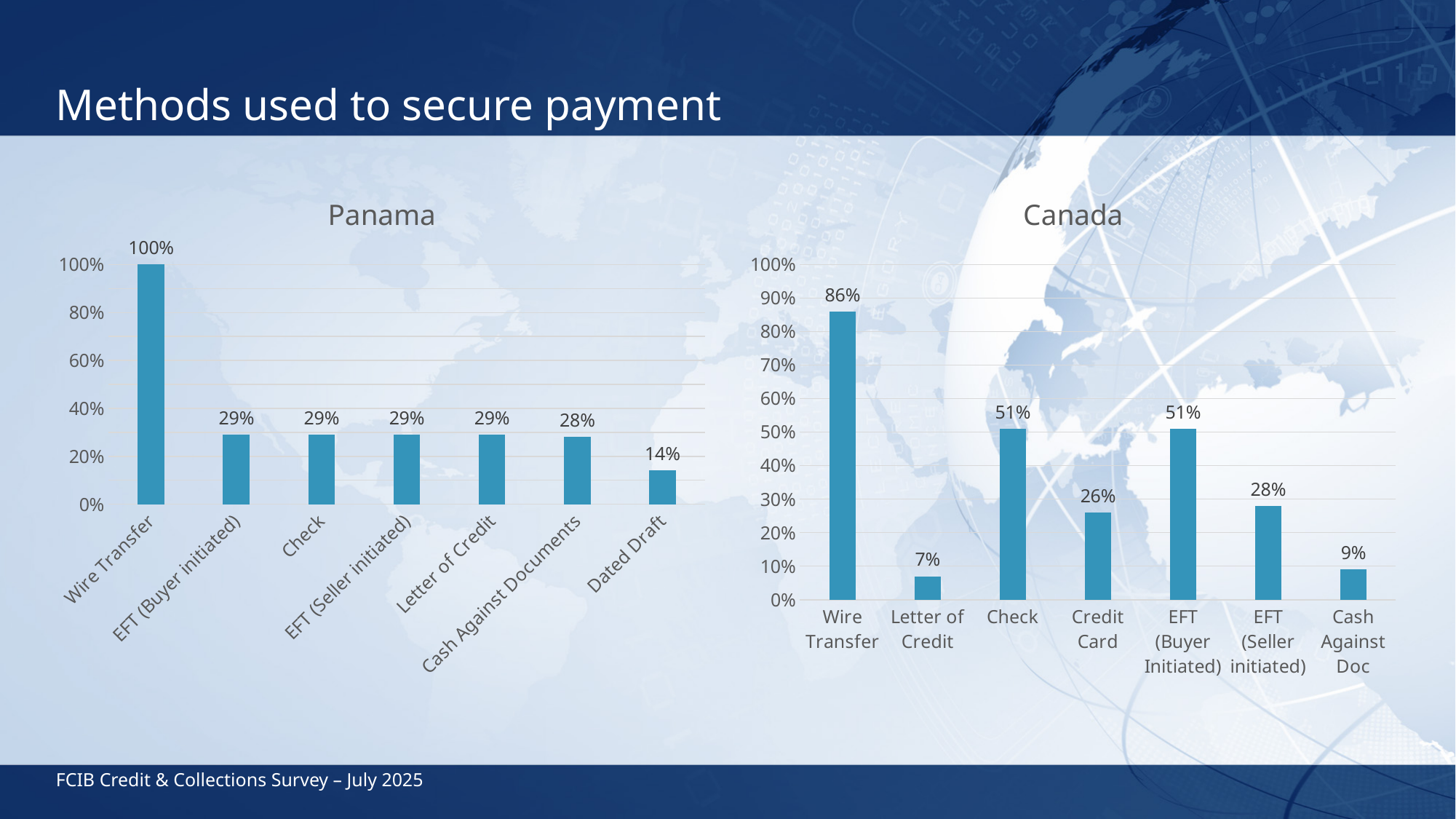
What kind of chart is the Panama chart? Bar chart In the Panama chart, what is the difference between Wire Transfer and Letter of Credit? 71% In the Canada chart, what is the value for Credit Card? 26% In the Panama chart, what is the value for Dated Draft? 14% In the Canada chart, which is larger, EFT (Seller initiated) or Cash Against Doc? EFT (Seller initiated) In the Canada chart, what is the value for Letter of Credit? 7% How many categories are shown in the Canada chart? 7 In the Panama chart, which category has the lowest value? Dated Draft In the Canada chart, what is the difference between Wire Transfer and Check? 35% In the Canada chart, which category has the highest value? Wire Transfer What is the title of the chart on the left side of the slide? Panama In the Panama chart, what is the value for Wire Transfer? 100%